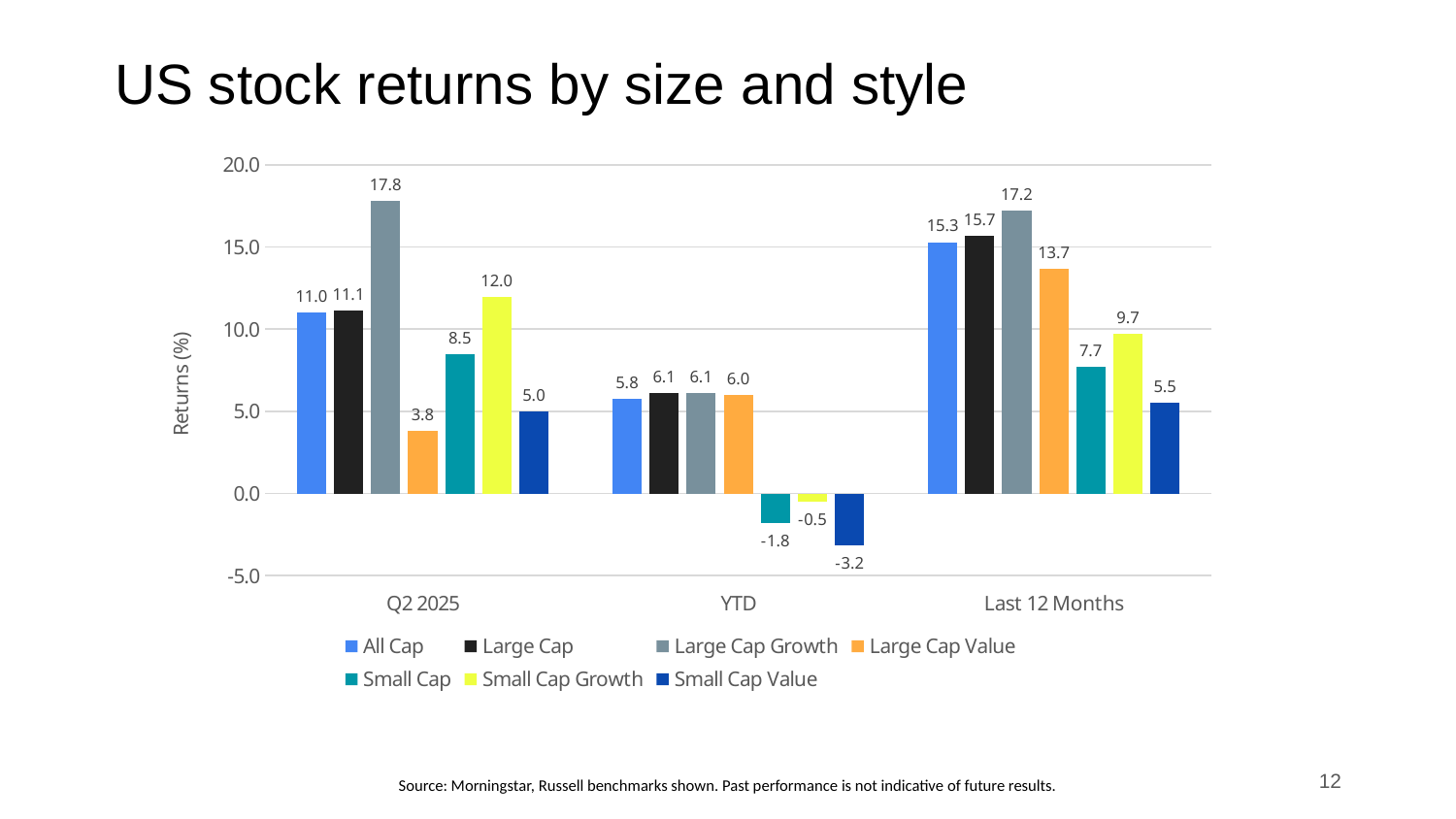
How many categories are shown on the x axis? 3 What is the Large Cap Value return for Last 12 Months? 13.7 What is the Large Cap Growth return for Q2 2025? 17.8 What is the label of the y axis? Returns (%) Which series has the highest return in the Last 12 Months category? Large Cap Growth Which series has the lowest return in the Q2 2025 category? Large Cap Value How many series does the legend list? 7 What is the Small Cap Value return for YTD? -3.2 Which is larger for Last 12 Months: the Small Cap return or the Small Cap Growth return? Small Cap Growth Is the All Cap return for Last 12 Months greater or less than 15.0? greater What is the difference between the Large Cap Growth and Small Cap Value returns for Q2 2025? 12.8 What kind of chart is shown on the slide? Bar chart